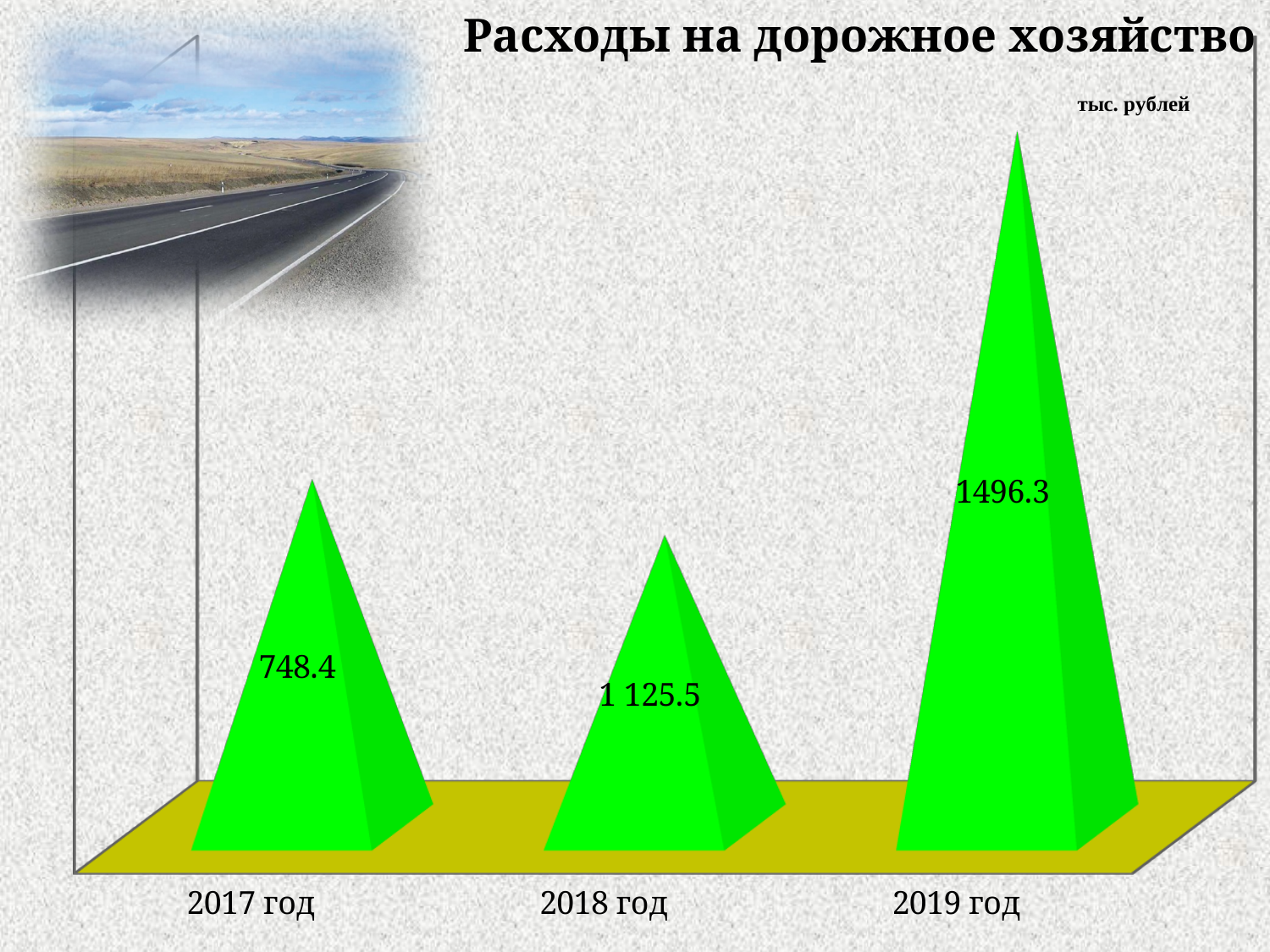
What is the difference between the values for 2019 год and 2018 год? 370.8 How many years are shown on the chart? 3 What is the value for 2018 год? 1 125.5 Which year has the highest value? 2019 год What is the difference between the values for 2019 год and 2017 год? 747.9 What is the title of the chart? Расходы на дорожное хозяйство Which is larger, the value for 2019 год or the value for 2017 год? 2019 год What kind of chart is shown on the slide? bar chart In what units are the values on the chart given? тыс. рублей What is the value for 2017 год? 748.4 What is the value for 2019 год? 1496.3